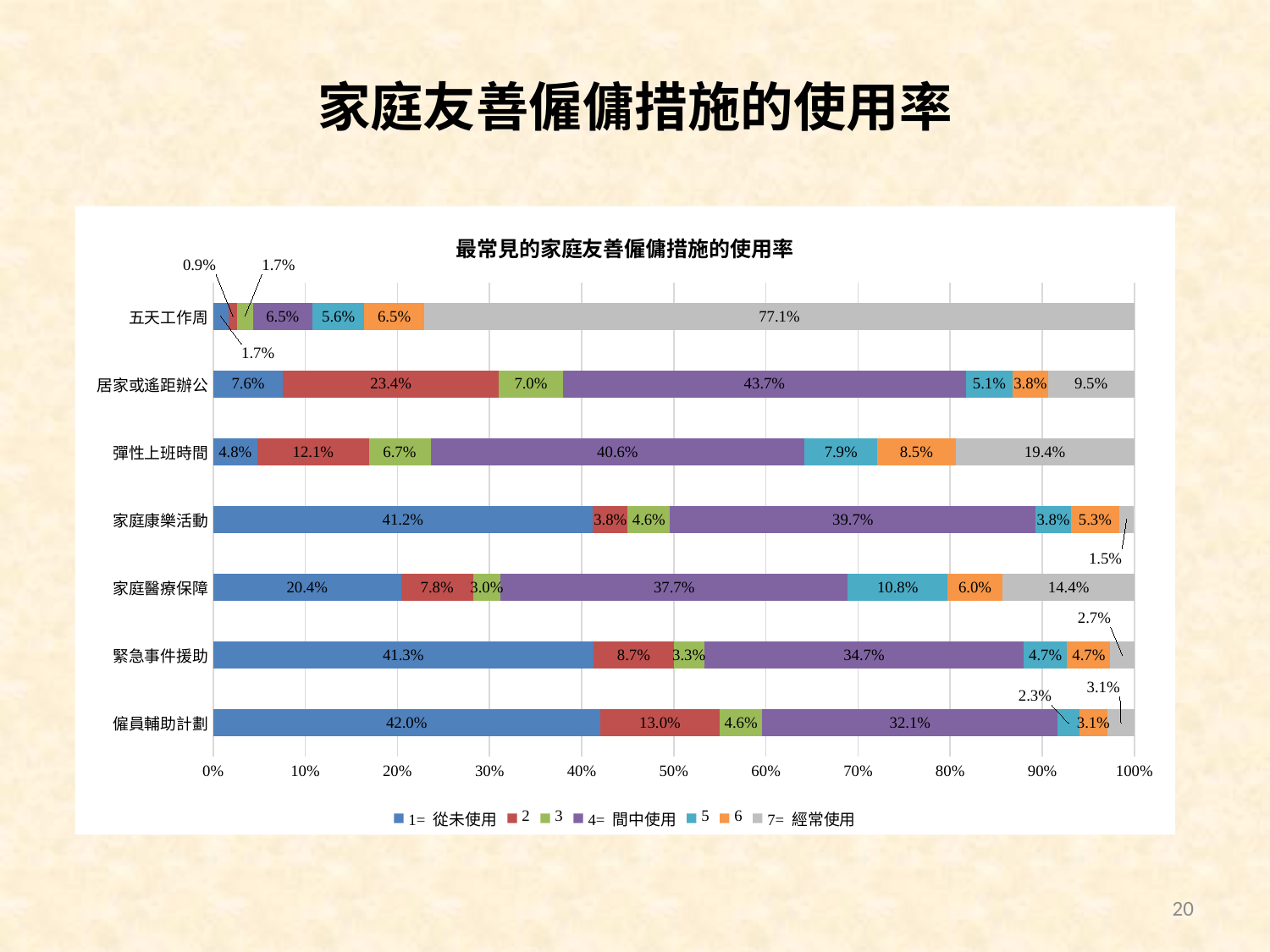
Which category has the lowest value for 1= 從未使用? 五天工作周 Which is larger: the 4= 間中使用 value for 彈性上班時間 or for 家庭醫療保障? 彈性上班時間 How many series does the legend list? 7 What is the value for 4= 間中使用 in the 居家或遙距辦公 category? 43.7% What is the value for 1= 從未使用 in the 僱員輔助計劃 category? 42.0% Which category has the highest value for 7= 經常使用? 五天工作周 What is the title of the chart? 最常見的家庭友善僱傭措施的使用率 What is the value for series 5 in the 家庭醫療保障 category? 10.8% How many categories are shown on the y axis of the chart? 7 What kind of chart is shown on the slide? Stacked bar chart What is the difference between the 1= 從未使用 values for 緊急事件援助 and 家庭醫療保障? 20.9% What is the value for 7= 經常使用 in the 五天工作周 category? 77.1%